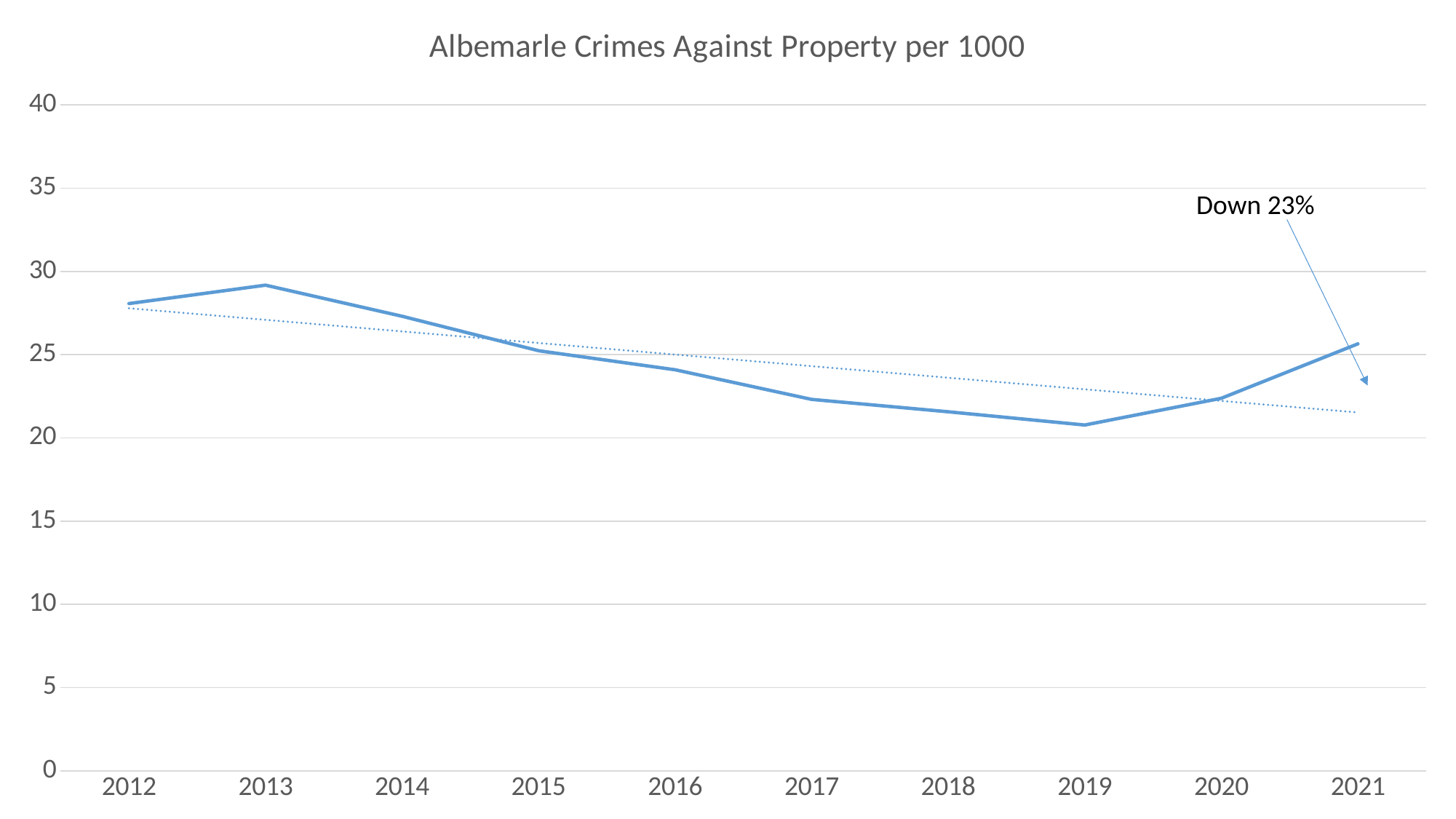
How many years are plotted along the x axis? 10 Is the value for 2019 greater or less than 25? less Do the values generally rise or fall from 2013 to 2019? fall Which year has the highest value? 2013 Which is larger, the value for 2013 or the value for 2019? 2013 What does the annotation near the 2021 point say? Down 23% Which year has the lowest value? 2019 What kind of chart is shown on the slide? line chart Is the value for 2012 greater or less than 30? less Is the value for 2013 greater or less than 25? greater What is the title of the chart? Albemarle Crimes Against Property per 1000